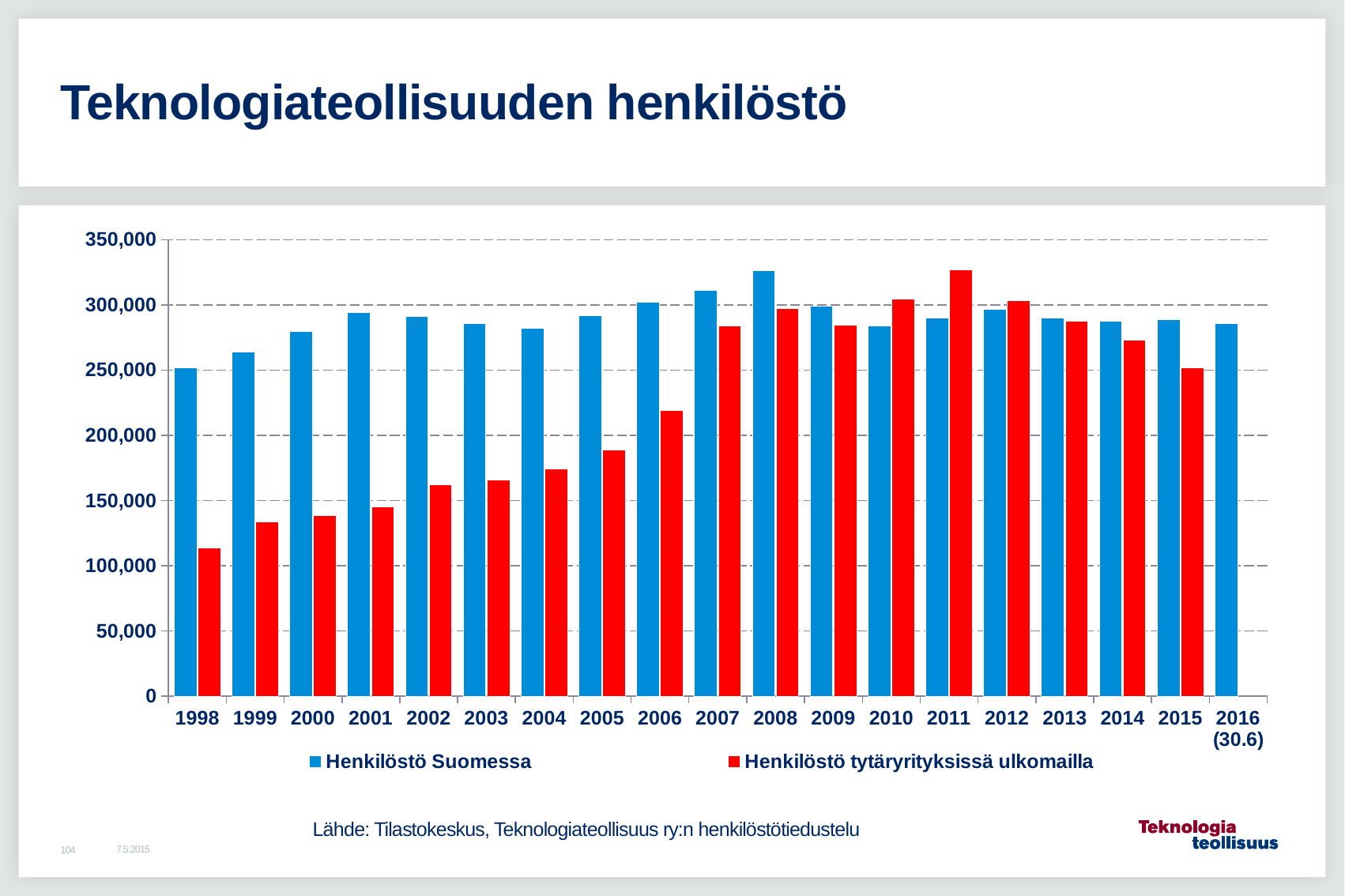
Does the value for Henkilöstö tytäryrityksissä ulkomailla rise or fall from 1998 to 2011? rise In which year is the value for Henkilöstö tytäryrityksissä ulkomailla highest? 2011 In which year is the value for Henkilöstö Suomessa highest? 2008 In 2011, which is larger: Henkilöstö Suomessa or Henkilöstö tytäryrityksissä ulkomailla? Henkilöstö tytäryrityksissä ulkomailla In 2006, which is larger: Henkilöstö Suomessa or Henkilöstö tytäryrityksissä ulkomailla? Henkilöstö Suomessa Is the value for Henkilöstö tytäryrityksissä ulkomailla in 2011 greater or less than 300,000? greater Is the value for Henkilöstö tytäryrityksissä ulkomailla in 1998 greater or less than 150,000? less What kind of chart is shown on the slide? bar chart How many series does the legend list? 2 Is the value for Henkilöstö Suomessa in 2008 greater or less than 300,000? greater In which year is the value for Henkilöstö tytäryrityksissä ulkomailla lowest? 1998 How many years are shown on the x axis? 19